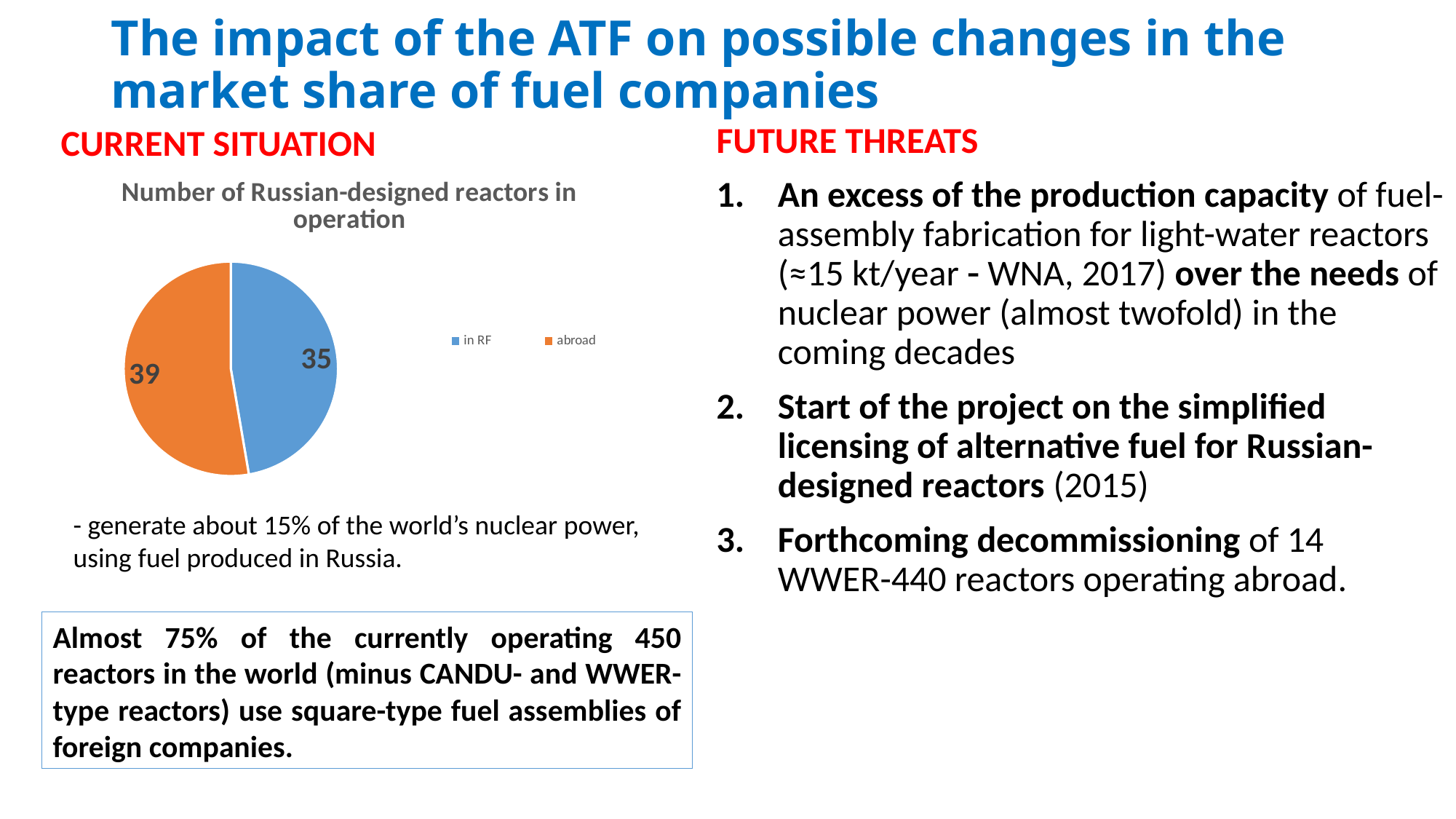
Which colour represents 'abroad' in the pie chart? Orange What is the total number of Russian-designed reactors in operation shown in the pie chart? 74 How many entries does the legend of the pie chart list? 2 Which category has the smallest value in the pie chart? in RF How many slices does the pie chart have? 2 Which category has the largest value in the pie chart? abroad How many Russian-designed reactors in operation are abroad according to the pie chart? 39 Which slice of the pie chart is larger, 'in RF' or 'abroad'? abroad What is the difference between the number of reactors abroad and in RF in the pie chart? 4 How many Russian-designed reactors in operation are in RF according to the pie chart? 35 What kind of chart is shown under 'CURRENT SITUATION'? Pie chart What is the title of the pie chart? Number of Russian-designed reactors in operation